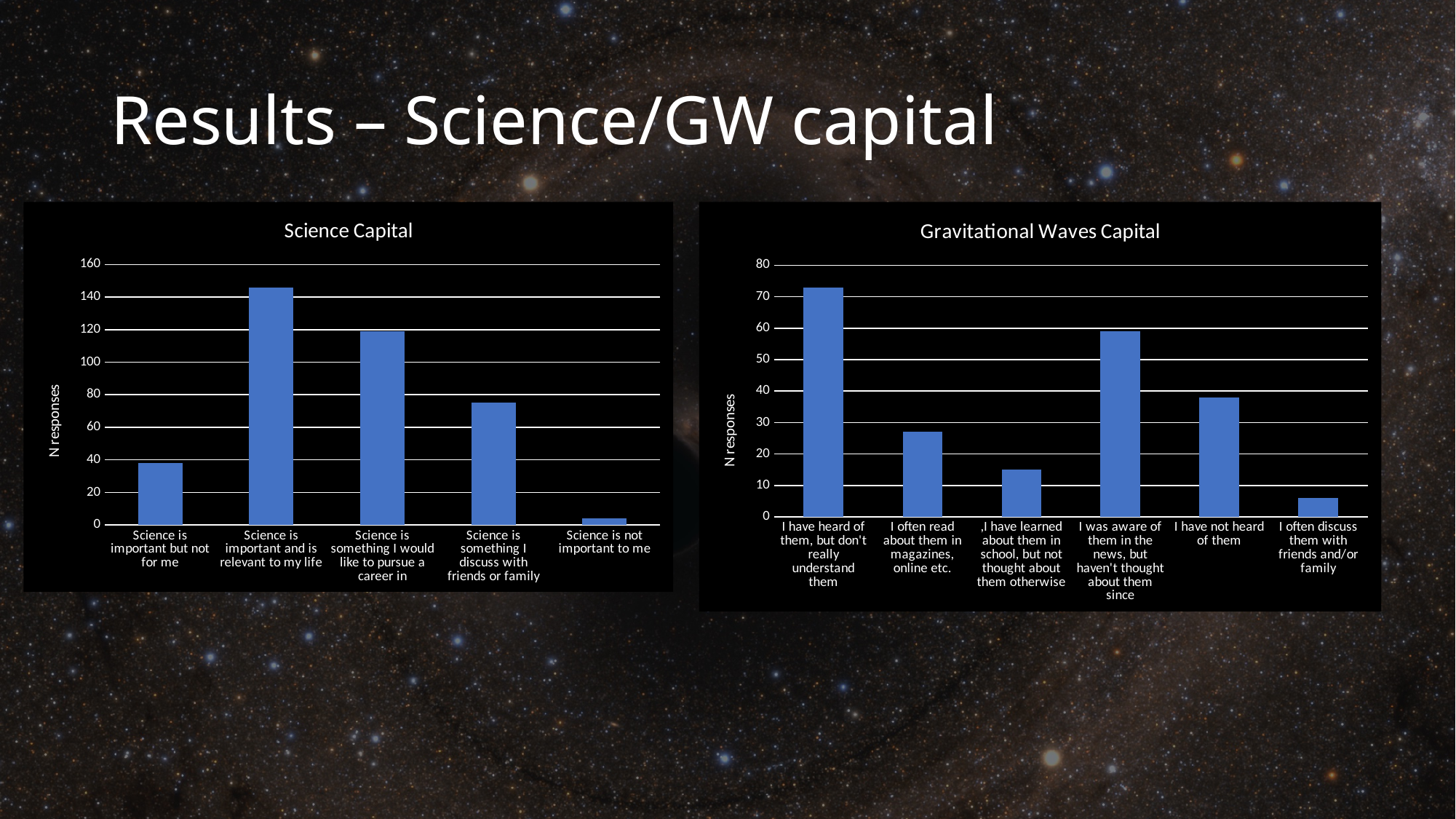
How many categories are shown in the Science Capital chart? 5 In the Science Capital chart, which category has the lowest number of responses? Science is not important to me In the Science Capital chart, is the value for 'Science is something I would like to pursue a career in' greater or less than 100? greater What type of chart is the Gravitational Waves Capital chart? Bar chart In the Gravitational Waves Capital chart, is the value for 'I was aware of them in the news, but haven't thought about them since' greater or less than 50? greater In the Science Capital chart, which category has the highest number of responses? Science is important and is relevant to my life In the Gravitational Waves Capital chart, which category has the lowest number of responses? I often discuss them with friends and/or family In the Science Capital chart, which is larger: 'Science is something I discuss with friends or family' or 'Science is important but not for me'? Science is something I discuss with friends or family How many categories are shown in the Gravitational Waves Capital chart? 6 In the Gravitational Waves Capital chart, which category has the highest number of responses? I have heard of them, but don't really understand them In the Gravitational Waves Capital chart, which is larger: 'I have not heard of them' or 'I often read about them in magazines, online etc.'? I have not heard of them